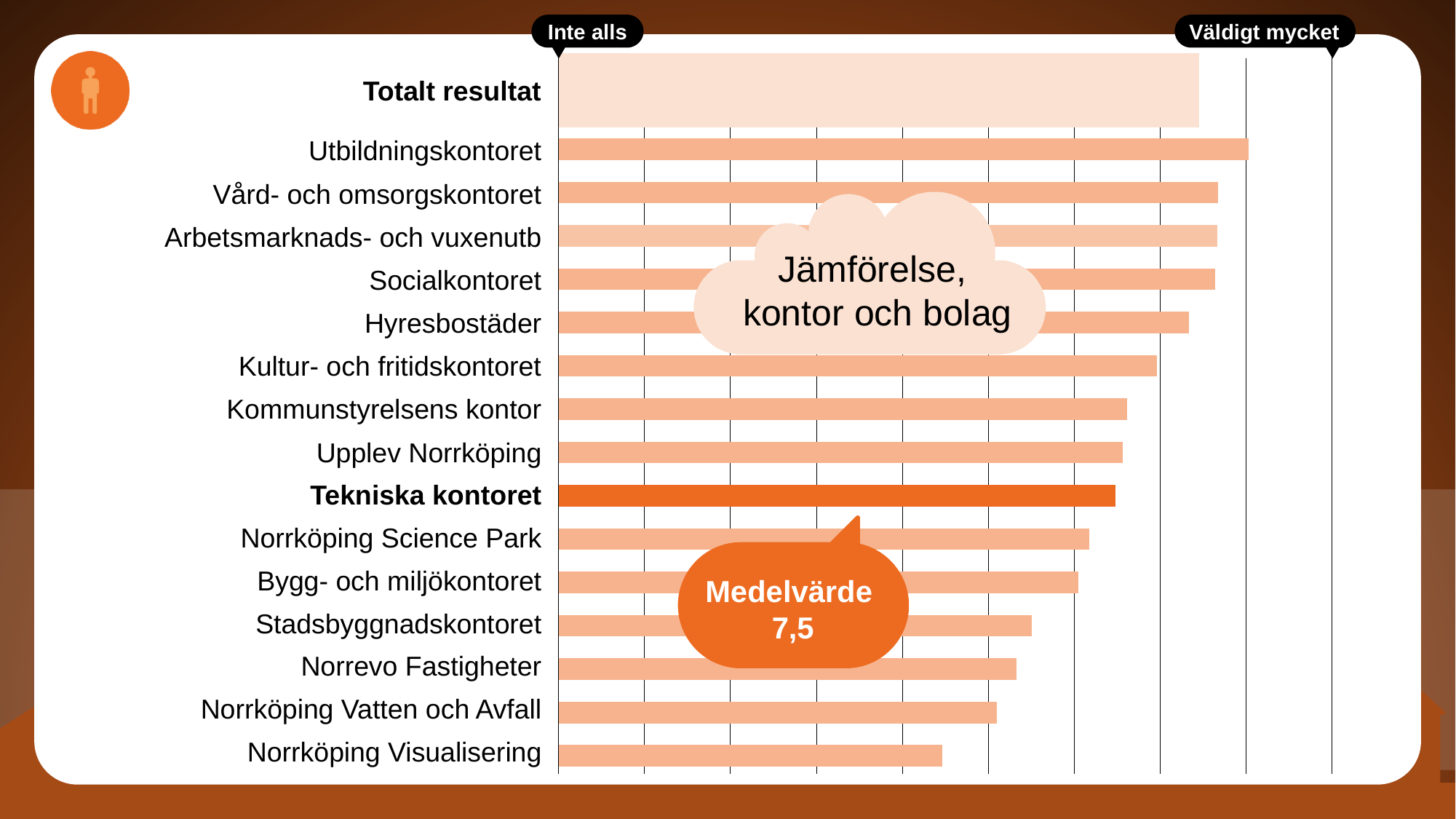
How many bars are plotted in the chart, including Totalt resultat? 16 Do the bar lengths increase or decrease going from the top of the chart to the bottom (below Totalt resultat)? decrease Which office or company has the shortest bar in the chart? Norrköping Visualisering How many offices and companies are listed below Totalt resultat in the chart? 15 Which bar is longer, Hyresbostäder or Norrevo Fastigheter? Hyresbostäder Which category's bar is highlighted in a darker orange colour? Tekniska kontoret Which office or company has the longest bar in the chart (excluding Totalt resultat)? Utbildningskontoret Which bar is longer, Utbildningskontoret or Norrköping Visualisering? Utbildningskontoret What kind of chart is shown on the slide? bar chart What is the title shown in the cloud shape on the chart? Jämförelse, kontor och bolag Which bar is longer, Tekniska kontoret or Norrköping Vatten och Avfall? Tekniska kontoret What is the mean value (Medelvärde) shown for Tekniska kontoret? 7,5